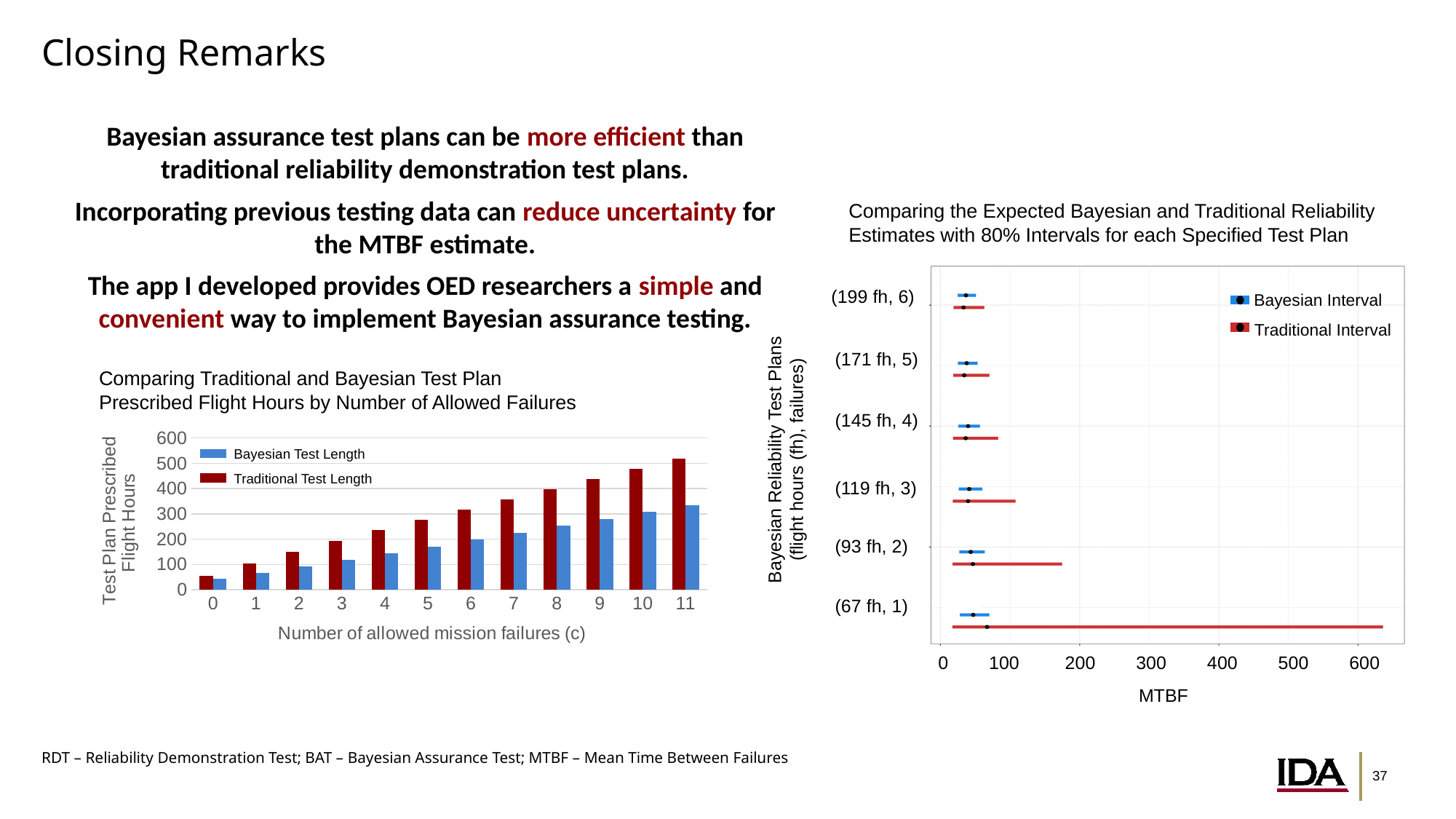
In the right chart comparing Bayesian and Traditional reliability estimates, what are the two legend entries? Bayesian Interval and Traditional Interval In the left bar chart, at which number of allowed mission failures is the Bayesian Test Length lowest? 0 In the left bar chart, do the Traditional Test Length values rise or fall as the number of allowed mission failures increases? rise In the left bar chart, which is larger for 8 allowed failures: the Bayesian Test Length or the Traditional Test Length? Traditional Test Length In the left bar chart, is the Traditional Test Length for 11 allowed failures greater or less than 500? greater In the left bar chart, how many series does the legend list? 2 What kind of chart is the left chart titled 'Comparing Traditional and Bayesian Test Plan Prescribed Flight Hours by Number of Allowed Failures'? bar chart In the left bar chart, at which number of allowed mission failures is the Traditional Test Length highest? 11 In the right chart comparing Bayesian and Traditional reliability estimates, how many test plans are listed on the y axis? 6 In the left bar chart, is the Bayesian Test Length for 11 allowed failures greater or less than 300? greater In the left bar chart, is the Traditional Test Length for 0 allowed failures greater or less than 100? less In the left bar chart, how many categories of allowed mission failures are shown on the x axis? 12